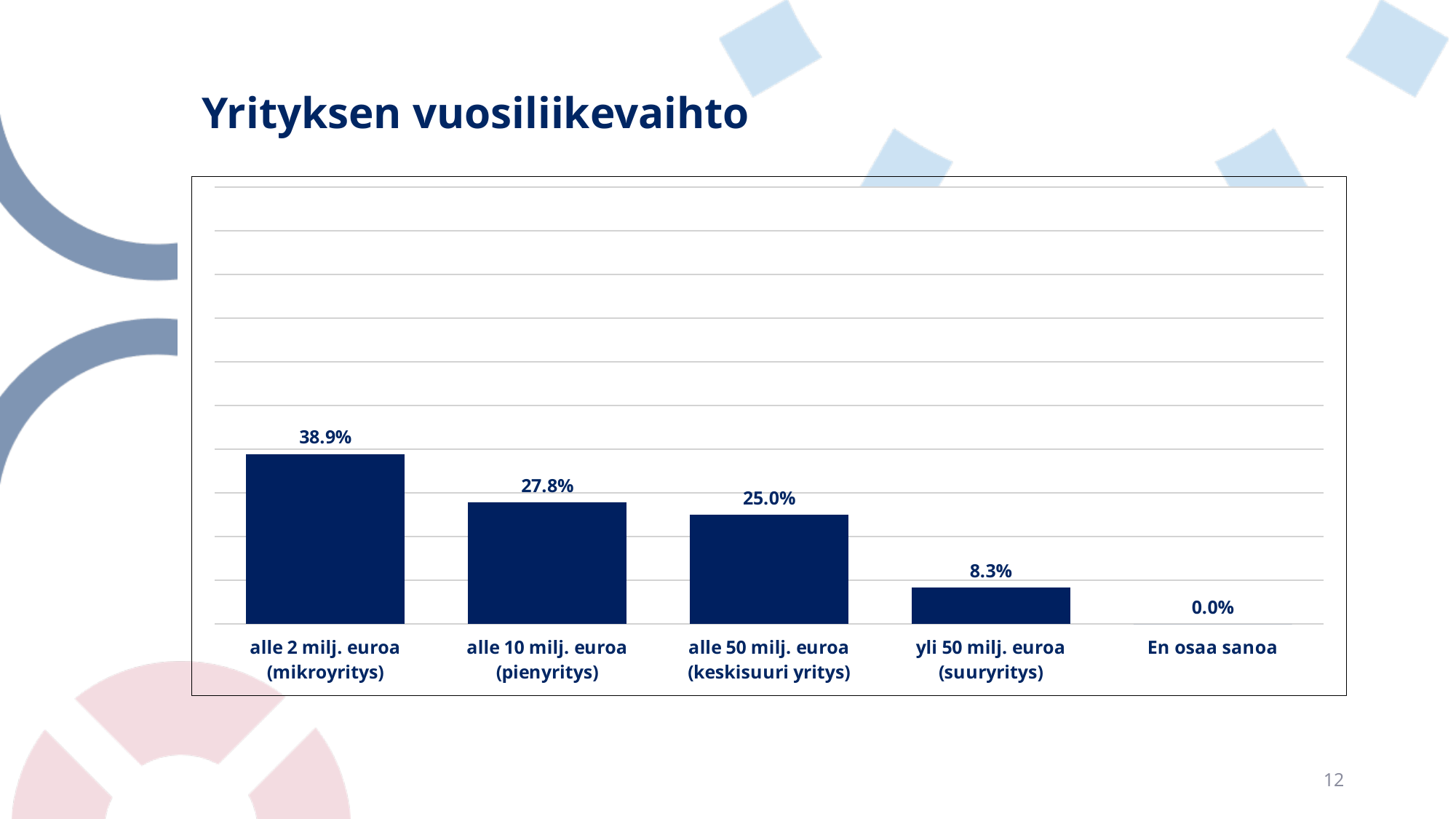
What is the value for 'yli 50 milj. euroa (suuryritys)'? 8.3% What is the value for 'alle 10 milj. euroa (pienyritys)'? 27.8% What is the title of the slide? Yrityksen vuosiliikevaihto What is the value for 'alle 50 milj. euroa (keskisuuri yritys)'? 25.0% What is the difference between the values for 'alle 2 milj. euroa (mikroyritys)' and 'alle 10 milj. euroa (pienyritys)'? 11.1% What is the value for 'En osaa sanoa'? 0.0% Which category has the highest value? alle 2 milj. euroa (mikroyritys) Which category has the lowest value? En osaa sanoa Which is larger: the value for 'alle 10 milj. euroa (pienyritys)' or 'alle 50 milj. euroa (keskisuuri yritys)'? alle 10 milj. euroa (pienyritys) What kind of chart is shown on the slide? bar chart What is the value for 'alle 2 milj. euroa (mikroyritys)'? 38.9% How many categories are shown on the x axis? 5